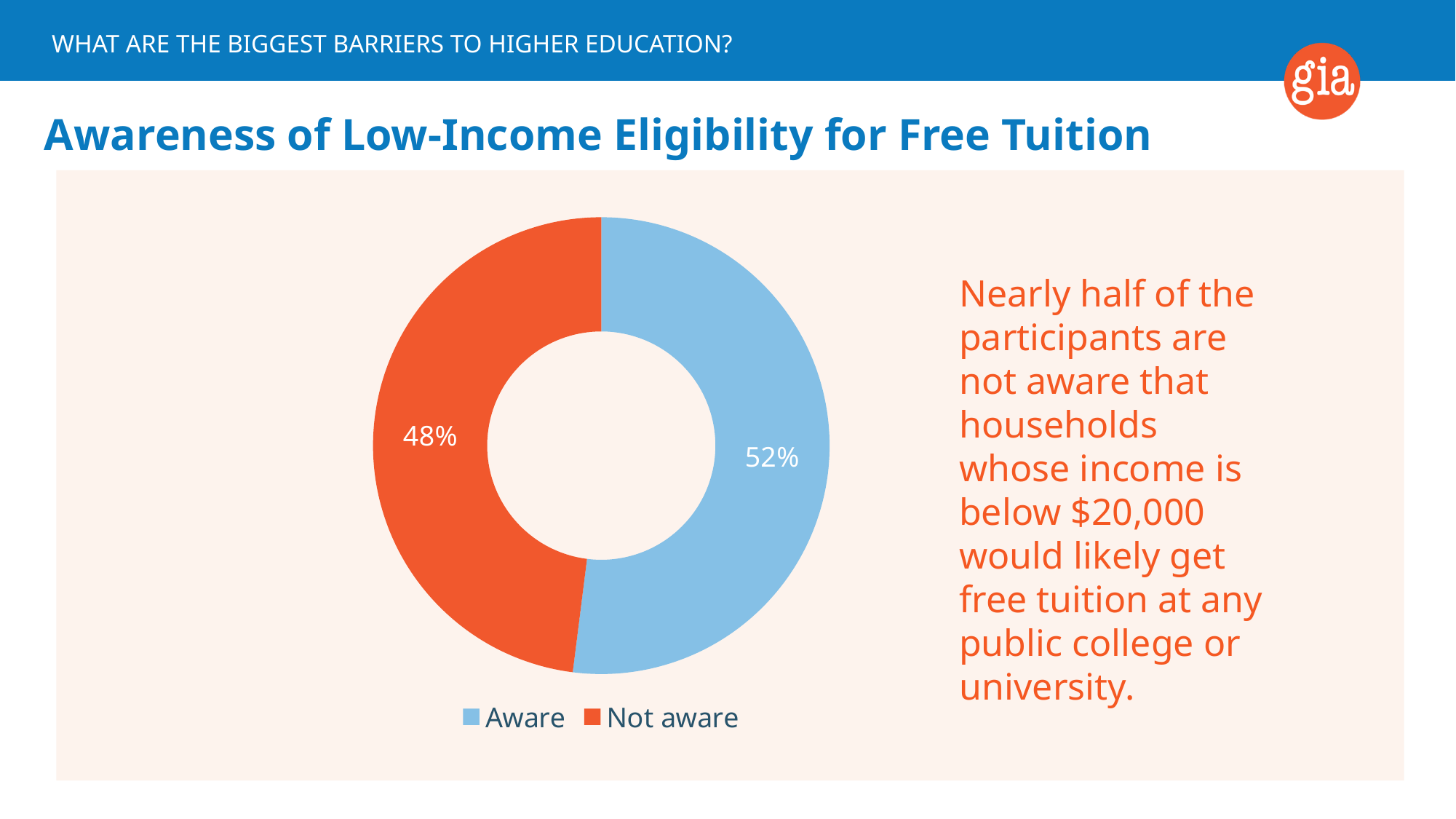
What kind of chart is shown on the slide? Pie chart (doughnut) What share of the chart does the Not aware slice represent? 48% Which category has the smaller share of the chart? Not aware Which category has the larger share of the chart? Aware How many entries does the legend list? 2 What is the difference in percentage points between the Aware and Not aware shares? 4 What percentage of participants are aware of low-income eligibility for free tuition? 52% What is the title of the chart on the slide? Awareness of Low-Income Eligibility for Free Tuition What percentage of participants are not aware of low-income eligibility for free tuition? 48% How many categories does the chart show? 2 What colour represents the Not aware category in the chart? Orange Is the share for Aware larger or smaller than the share for Not aware? larger